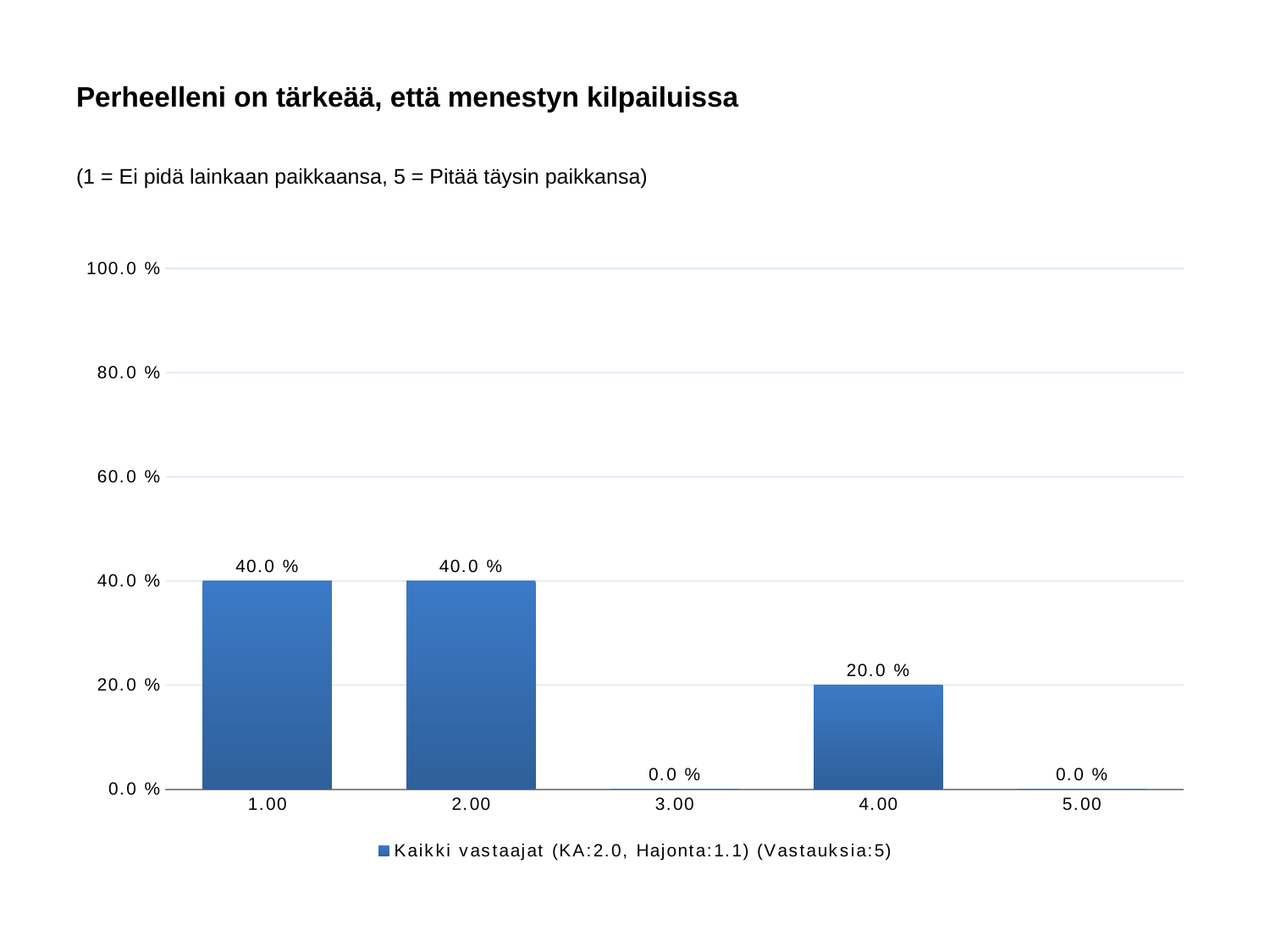
What is the value for category 4.00? 20.0 % What is the title of the slide? Perheelleni on tärkeää, että menestyn kilpailuissa Which is larger, the value for 2.00 or the value for 4.00? 2.00 What is the value for category 5.00? 0.0 % What is the value for category 1.00? 40.0 % How many categories are shown on the x axis? 5 What is the difference between the values for 1.00 and 4.00? 20.0 % How many series does the legend list? 1 Is the value for 4.00 greater or less than 40.0 %? less What kind of chart is shown? bar chart What is the value for category 3.00? 0.0 % Which category has the lowest value, 2.00 or 4.00? 4.00